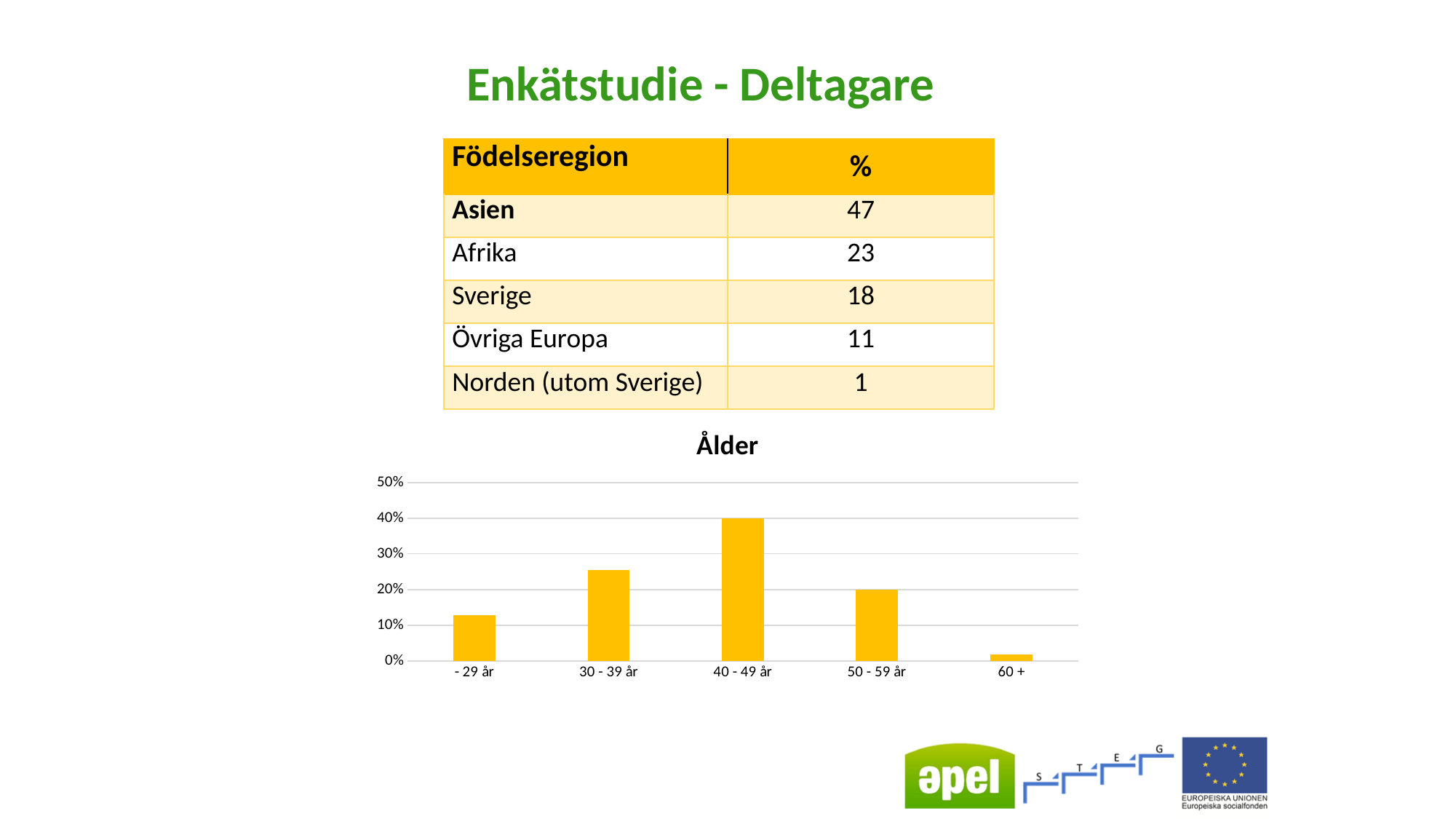
What is the value for 50 - 59 år in the "Ålder" chart? 20% What is the title of the bar chart on the slide? Ålder Which age category has the highest value in the "Ålder" chart? 40 - 49 år In the "Ålder" chart, is the value for - 29 år greater or less than 10%? greater What is the highest value shown on the vertical axis of the "Ålder" chart? 50% In the "Ålder" chart, is the value for 60 + greater or less than 10%? less In the "Ålder" chart, which is larger: the value for 30 - 39 år or the value for 50 - 59 år? 30 - 39 år Which age category has the lowest value in the "Ålder" chart? 60 + How many age categories are shown in the "Ålder" chart? 5 What is the value for 40 - 49 år in the "Ålder" chart? 40% What kind of chart is the "Ålder" chart? bar chart In the "Ålder" chart, is the value for 30 - 39 år greater or less than 30%? less